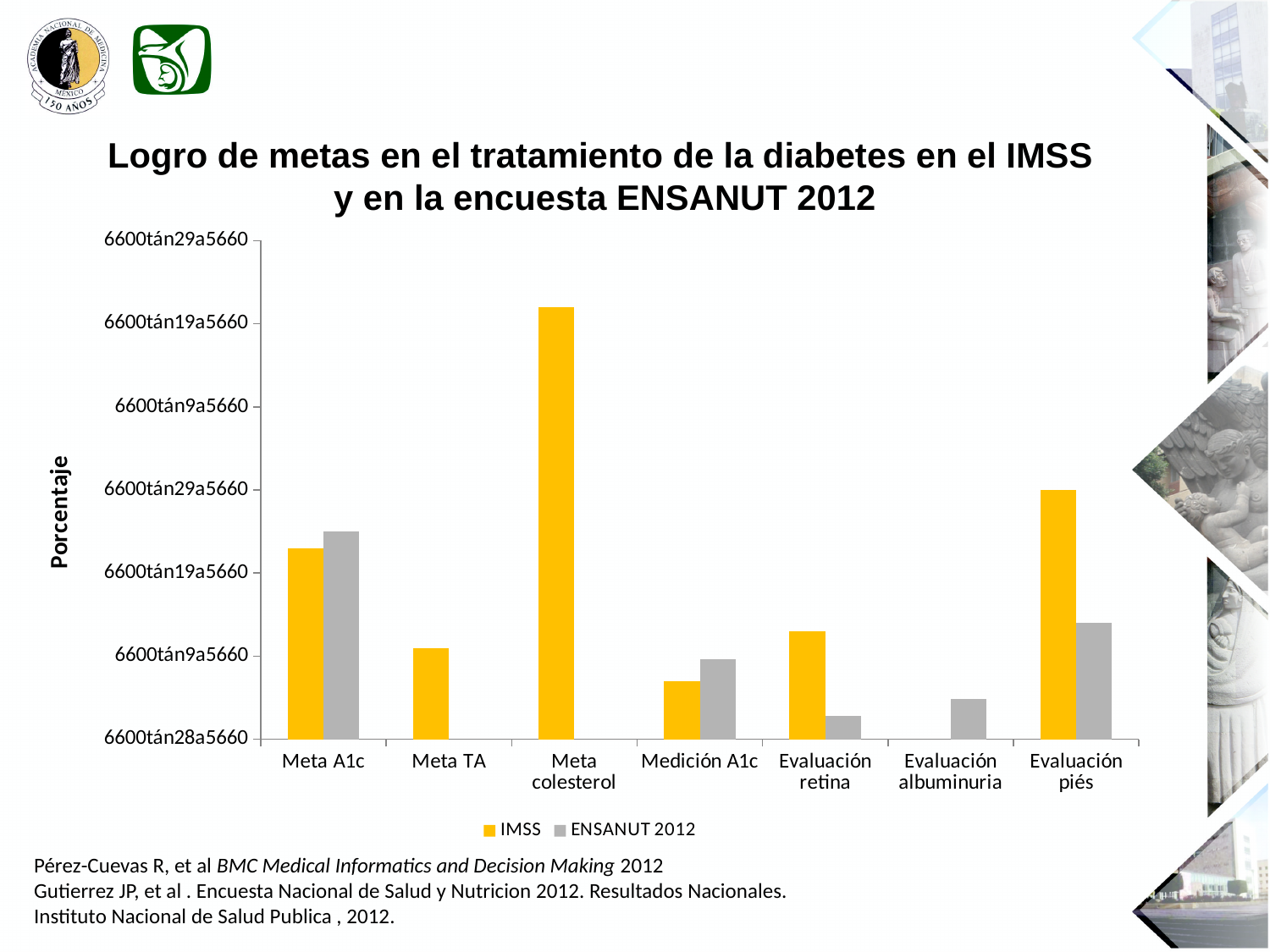
What is the label of the vertical axis of the chart? Porcentaje How many categories are shown on the x axis of the chart? 7 Which series is shown in yellow in the chart? IMSS Which category has the lowest IMSS value? Medición A1c For Medición A1c, which series has the larger value, IMSS or ENSANUT 2012? ENSANUT 2012 For Evaluación retina, which series has the larger value, IMSS or ENSANUT 2012? IMSS Which category has the highest ENSANUT 2012 value? Meta A1c Which category has the highest IMSS value? Meta colesterol For Evaluación piés, which series has the larger value, IMSS or ENSANUT 2012? IMSS How many series does the chart legend list? 2 What kind of chart is shown on the slide? bar chart